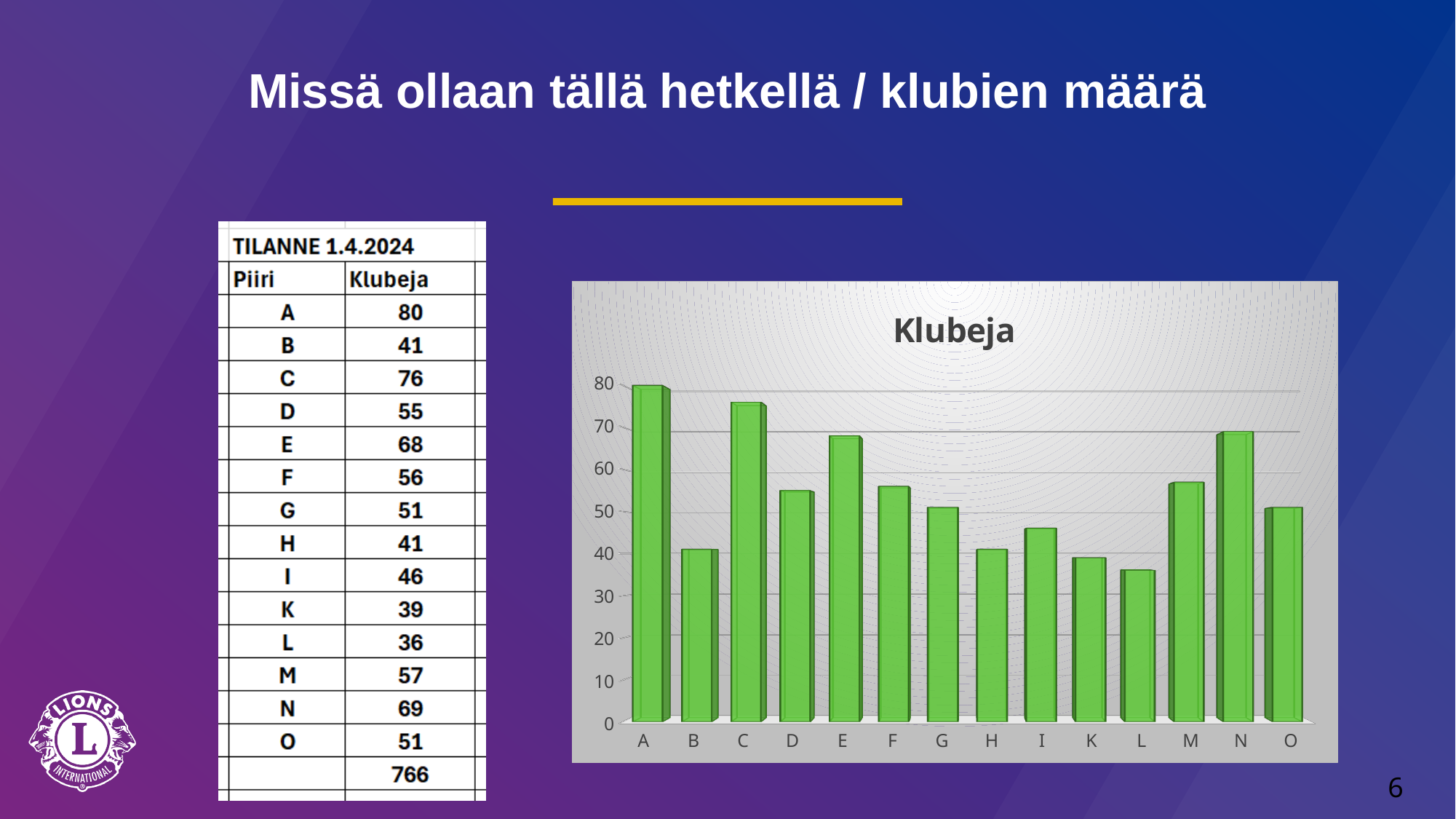
What is the difference between the values for A and B? 39 How many categories are plotted on the x axis of the chart? 14 What colour are the bars in the chart? green Which category has the highest bar in the chart? A Is the value for K greater or less than 40? less Which is larger, the value for C or the value for E? C Which category has the lowest bar in the chart? L What kind of chart is shown on the slide? bar chart Is the value for C greater or less than 70? greater What is the title of the chart? Klubeja What is the value for category N in the chart? 69 What is the value for category A in the chart? 80